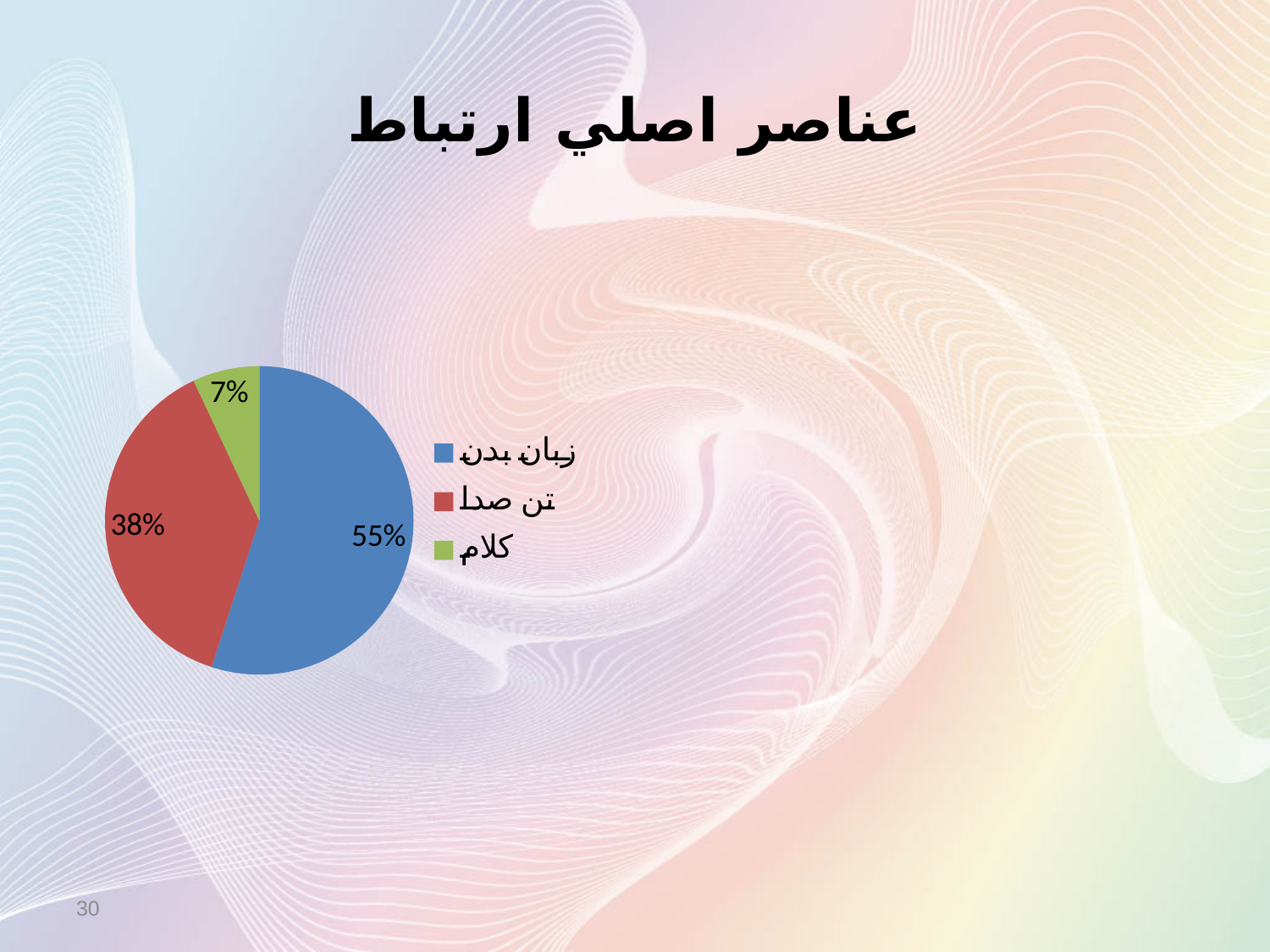
What percentage of the pie is the slice for تن صدا? 38% What is the difference in percentage points between the slices for تن صدا and کلام? 31 What colour is the slice for کلام in the pie chart? green What is the title of the slide containing the pie chart? عناصر اصلي ارتباط Which category has the largest slice of the pie? زبان بدن What percentage of the pie is the slice for کلام? 7% Which slice is larger, تن صدا or کلام? تن صدا What percentage of the pie is the slice for زبان بدن? 55% What is the difference in percentage points between the slices for زبان بدن and تن صدا? 17 What kind of chart is shown on the slide? pie chart How many slices does the pie chart have? 3 Which category has the smallest slice of the pie? کلام